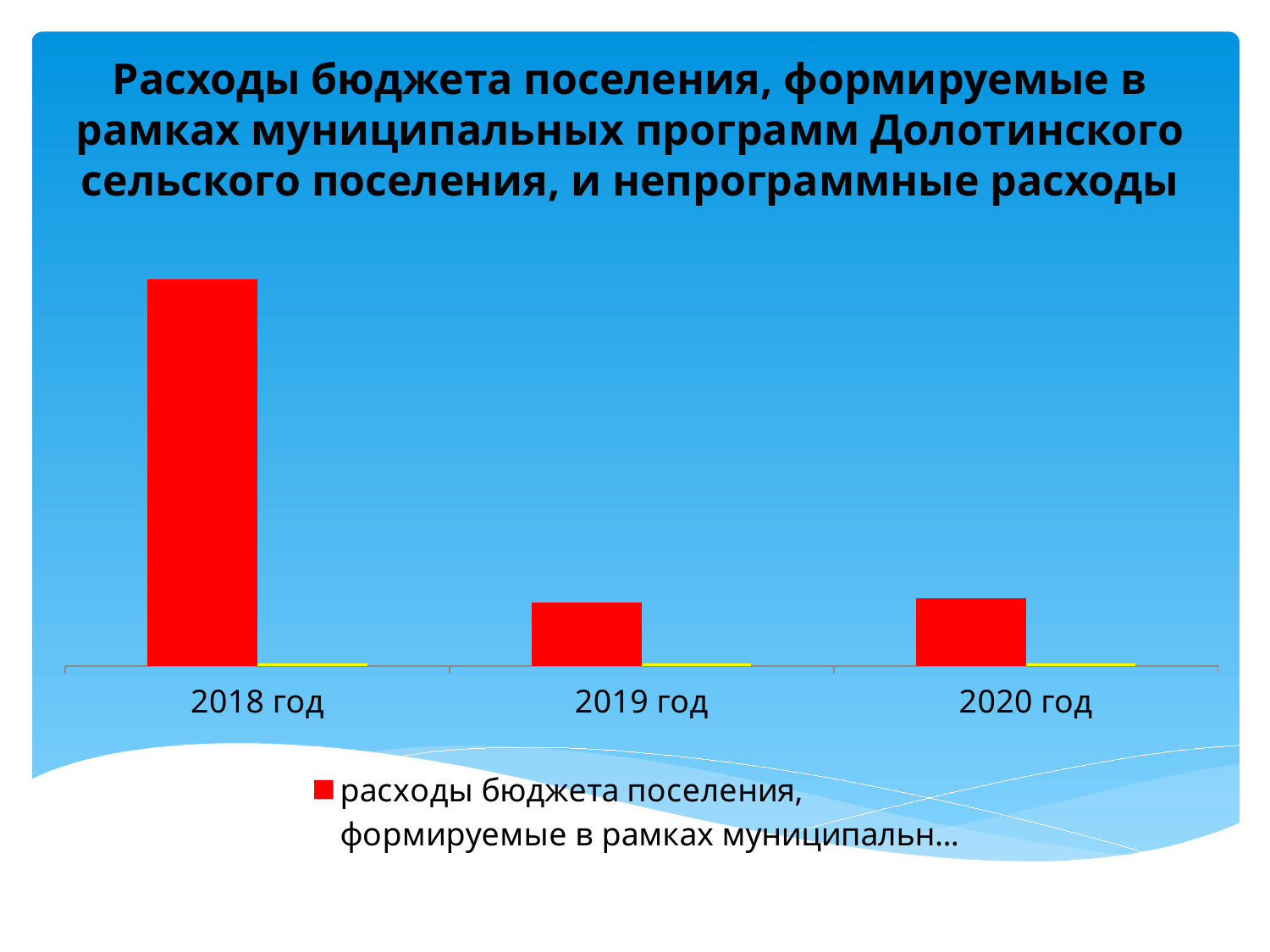
Which year has the tallest red bar in the chart? 2018 год Is the red bar for 2020 год taller or shorter than the red bar for 2018 год? shorter What kind of chart is shown on the slide? bar chart How many series entries are listed in the chart legend? 1 What colour are the bars for the series listed in the legend? red How many year categories are shown on the x axis of the chart? 3 Is the red bar for 2018 год taller or shorter than the red bar for 2019 год? taller Does the red series rise or fall from 2018 год to 2019 год? fall What is the first year category shown on the x axis? 2018 год